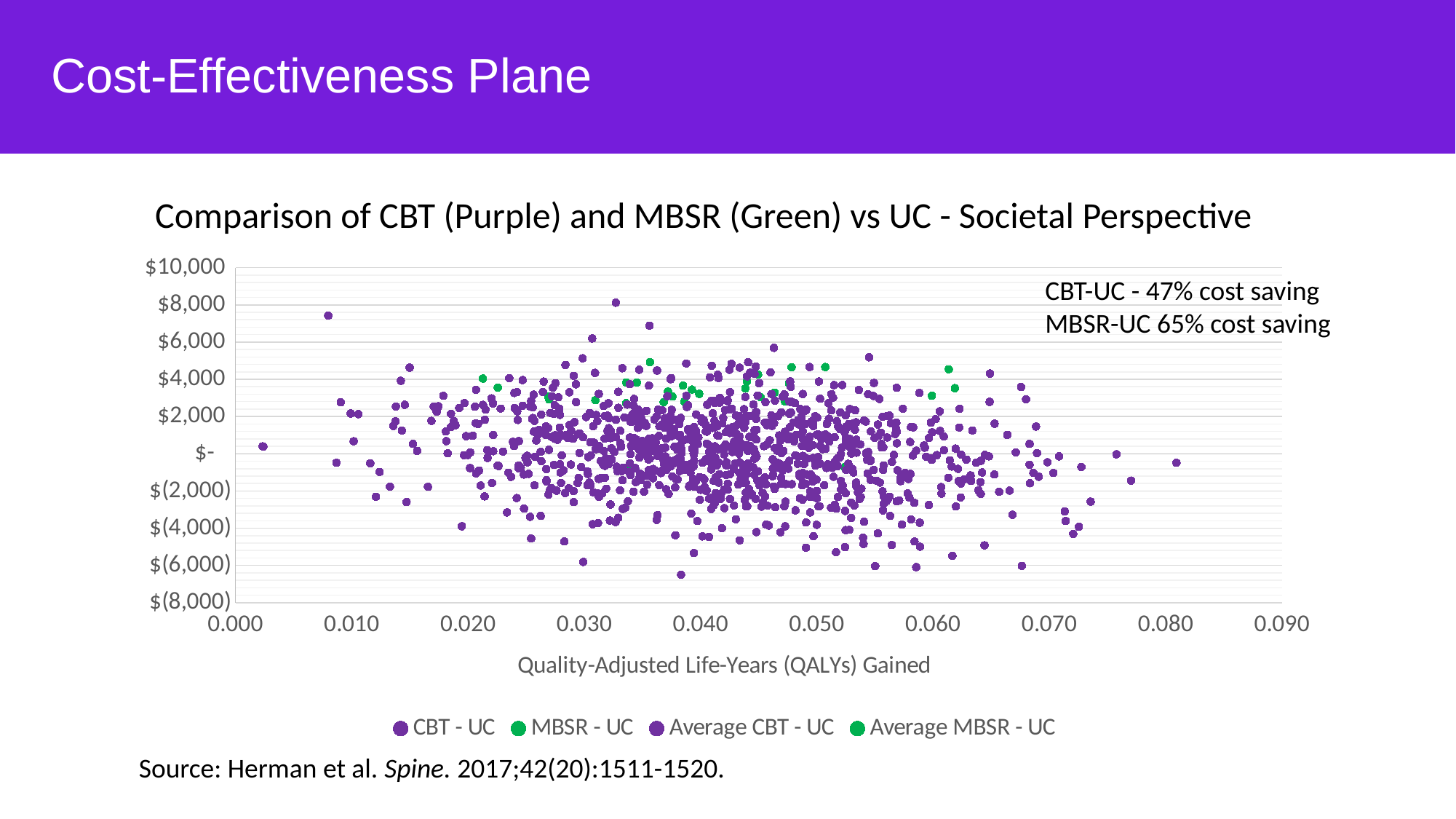
According to the annotation on the chart, what is the cost saving for CBT-UC? 47% cost saving According to the annotation on the chart, what is the cost saving for MBSR-UC? 65% cost saving What is the label of the x axis? Quality-Adjusted Life-Years (QALYs) Gained What kind of chart is shown on the slide? Scatter plot What is the title of the chart? Comparison of CBT (Purple) and MBSR (Green) vs UC - Societal Perspective Which series has more points plotted, CBT - UC or MBSR - UC? CBT - UC Is the highest CBT - UC point on the chart greater or less than $6,000? greater How many series does the legend list? 4 Which comparison shows the larger cost saving in the annotation, CBT-UC or MBSR-UC? MBSR-UC Is the lowest CBT - UC point on the chart greater or less than $(4,000)? less